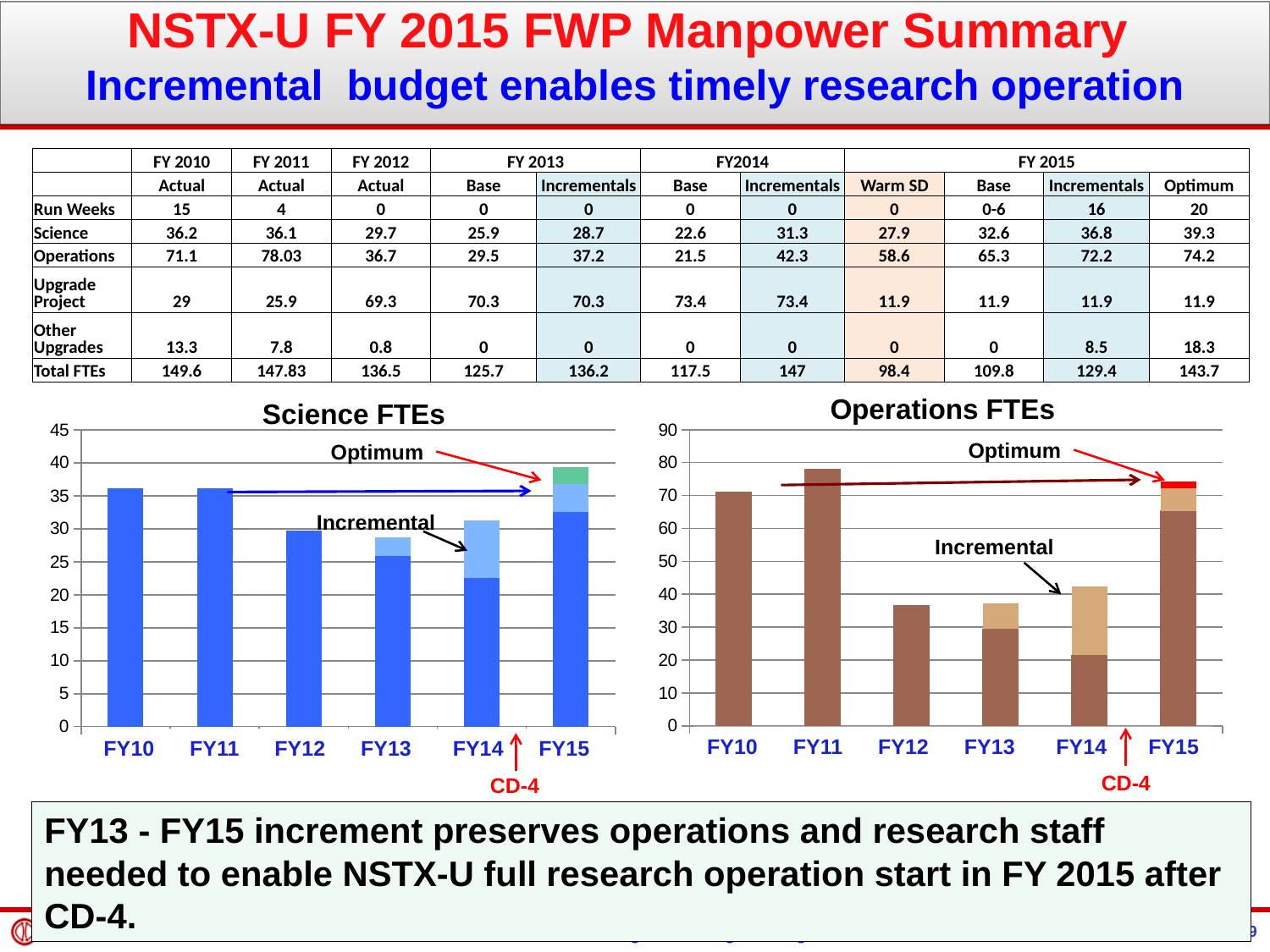
In the Science FTEs chart, do the base (dark blue) bars rise or fall from FY11 to FY14? fall In the Operations FTEs chart, is the value for FY12 greater or less than 40? less In the Science FTEs chart, which fiscal year has the lowest base (dark blue) bar? FY14 In the Operations FTEs chart, what colour is the 'Optimum' segment on the FY15 bar? red What kind of chart is the Science FTEs chart? bar chart How many fiscal years are shown on the x axis of the Operations FTEs chart? 6 In the Operations FTEs chart, which is larger, the bar for FY10 or the bar for FY12? FY10 In the Operations FTEs chart, which fiscal year has the lowest base (brown) bar? FY14 In the Science FTEs chart, which fiscal year's bar includes the 'Optimum' segment? FY15 In the Operations FTEs chart, is the value for FY10 greater or less than 60? greater In the Science FTEs chart, is the total height of the FY13 bar greater or less than 30? less